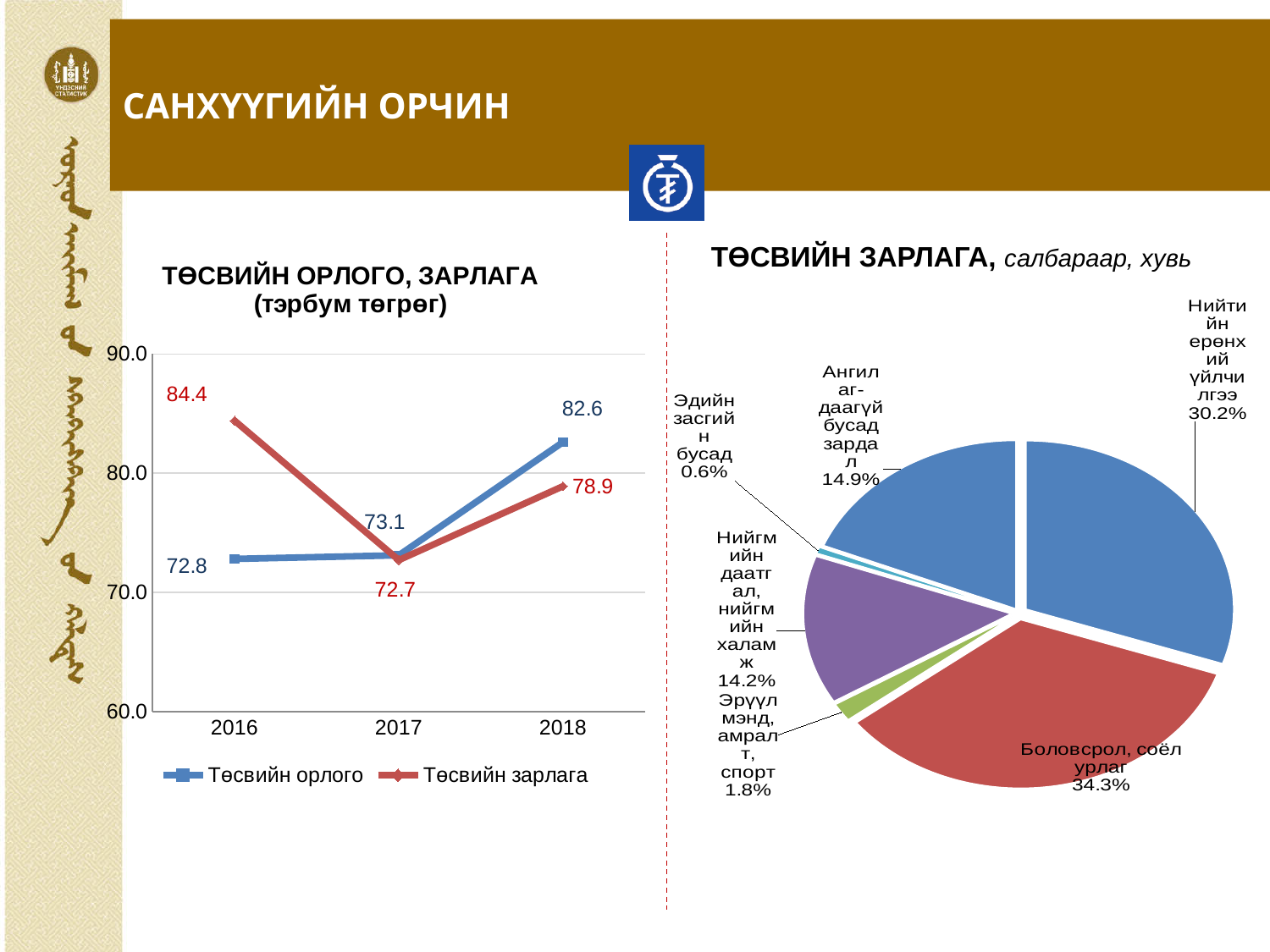
In the pie chart 'ТӨСВИЙН ЗАРЛАГА, салбараар, хувь', what share does Боловсрол, соёл урлаг have? 34.3% In the line chart 'ТӨСВИЙН ОРЛОГО, ЗАРЛАГА', what is the value of Төсвийн орлого in 2018? 82.6 What kind of chart is the chart on the left of the slide? line chart In the pie chart 'ТӨСВИЙН ЗАРЛАГА, салбараар, хувь', how many slices are there? 6 In the line chart 'ТӨСВИЙН ОРЛОГО, ЗАРЛАГА', in which year is Төсвийн зарлага lowest? 2017 In the line chart 'ТӨСВИЙН ОРЛОГО, ЗАРЛАГА', what is the value of Төсвийн зарлага in 2016? 84.4 In the line chart 'ТӨСВИЙН ОРЛОГО, ЗАРЛАГА', does Төсвийн орлого rise or fall from 2016 to 2018? rise In the line chart 'ТӨСВИЙН ОРЛОГО, ЗАРЛАГА', what is the difference between Төсвийн орлого and Төсвийн зарлага in 2018? 3.7 In the line chart 'ТӨСВИЙН ОРЛОГО, ЗАРЛАГА', which is larger in 2016, Төсвийн орлого or Төсвийн зарлага? Төсвийн зарлага In the pie chart 'ТӨСВИЙН ЗАРЛАГА, салбараар, хувь', which category has the smallest share? Эдийн засгийн бусад In the pie chart 'ТӨСВИЙН ЗАРЛАГА, салбараар, хувь', what is the difference between the shares of Ангилагдаагүй бусад зардал and Нийгмийн даатгал, нийгмийн халамж? 0.7% In the line chart 'ТӨСВИЙН ОРЛОГО, ЗАРЛАГА', how many series does the legend list? 2